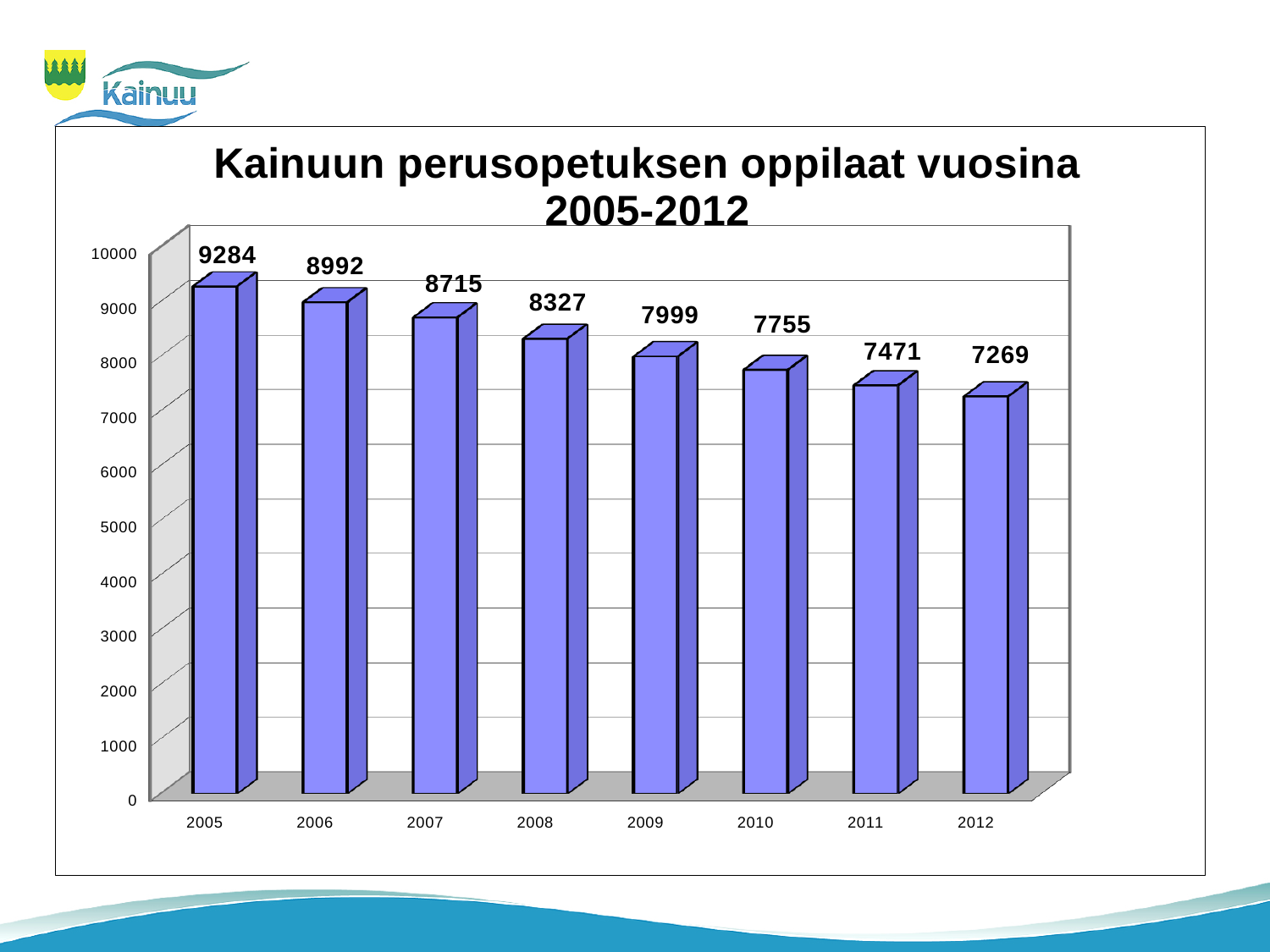
How many years are shown on the x axis? 8 What is the value for 2009? 7999 What is the difference between the values for 2007 and 2008? 388 What kind of chart is shown on the slide? bar chart What is the value for 2012? 7269 Which year has the highest value? 2005 Which is larger, the value for 2006 or the value for 2010? 2006 Is the value for 2011 greater or less than 8000? less Do the values rise or fall from 2005 to 2012? fall Which year has the lowest value? 2012 What is the difference between the values for 2005 and 2012? 2015 What is the value for 2005? 9284